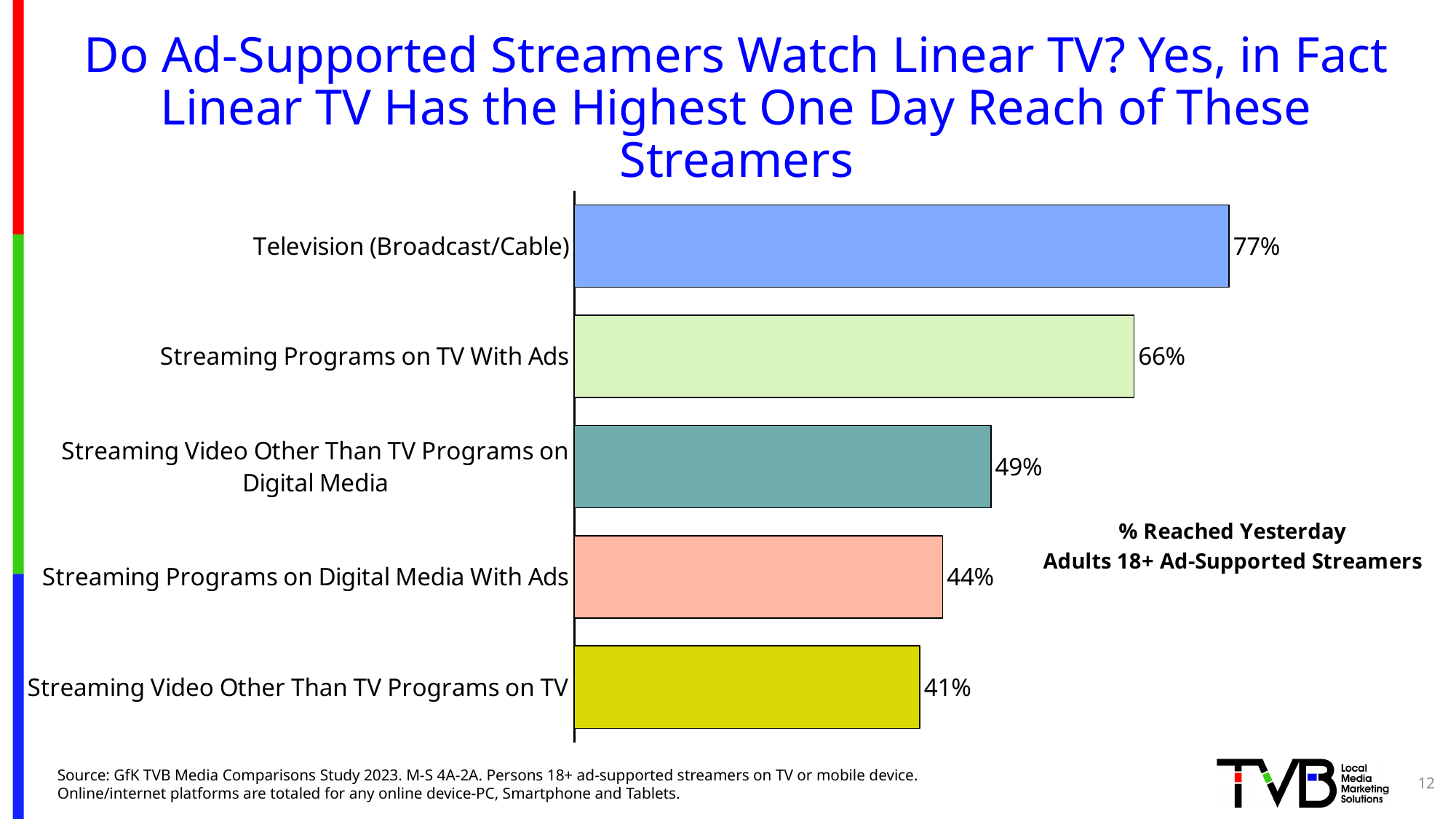
What is the value for Streaming Programs on Digital Media With Ads? 44% What is the difference between the reach of Television (Broadcast/Cable) and Streaming Programs on TV With Ads? 11% What kind of chart is shown on the slide? Bar chart Which category has the lowest one-day reach? Streaming Video Other Than TV Programs on TV How many categories are shown in the chart? 5 Which category has the highest one-day reach? Television (Broadcast/Cable) Which is larger: the reach of Streaming Programs on Digital Media With Ads or Streaming Video Other Than TV Programs on Digital Media? Streaming Video Other Than TV Programs on Digital Media What percentage of ad-supported streamers were reached yesterday by Television (Broadcast/Cable)? 77% What is the value for Streaming Video Other Than TV Programs on TV? 41% What is the value for Streaming Programs on TV With Ads? 66% What audience does the chart's label say the percentages refer to? Adults 18+ Ad-Supported Streamers What is the value for Streaming Video Other Than TV Programs on Digital Media? 49%